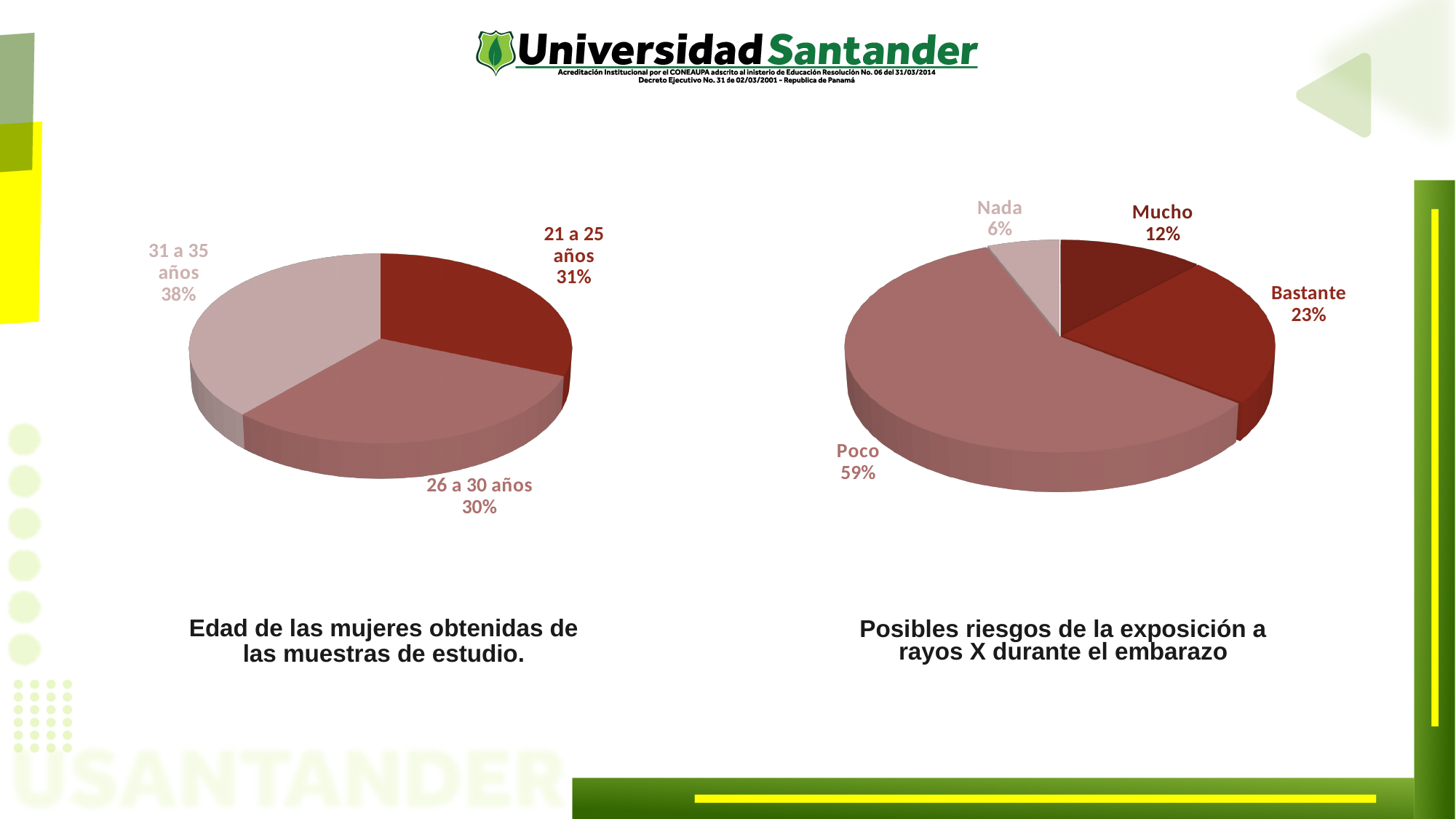
In the right chart (Posibles riesgos de la exposición a rayos X durante el embarazo), what share is shown for Poco? 59% In the left chart (Edad de las mujeres obtenidas de las muestras de estudio), what is the difference in percentage points between 31 a 35 años and 26 a 30 años? 8 In the right chart (Posibles riesgos de la exposición a rayos X durante el embarazo), what is the difference in percentage points between Poco and Bastante? 36 In the left chart (Edad de las mujeres obtenidas de las muestras de estudio), which age group has the smallest share? 26 a 30 años In the left chart (Edad de las mujeres obtenidas de las muestras de estudio), how many age groups are shown? 3 In the right chart (Posibles riesgos de la exposición a rayos X durante el embarazo), which is larger, Bastante or Mucho? Bastante In the left chart (Edad de las mujeres obtenidas de las muestras de estudio), what share is shown for 21 a 25 años? 31% What type of chart is used for the right chart (Posibles riesgos de la exposición a rayos X durante el embarazo)? Pie chart In the right chart (Posibles riesgos de la exposición a rayos X durante el embarazo), what share is shown for Nada? 6% In the left chart (Edad de las mujeres obtenidas de las muestras de estudio), which age group has the largest share? 31 a 35 años In the right chart (Posibles riesgos de la exposición a rayos X durante el embarazo), which category has the smallest share? Nada In the left chart (Edad de las mujeres obtenidas de las muestras de estudio), what share is shown for 31 a 35 años? 38%